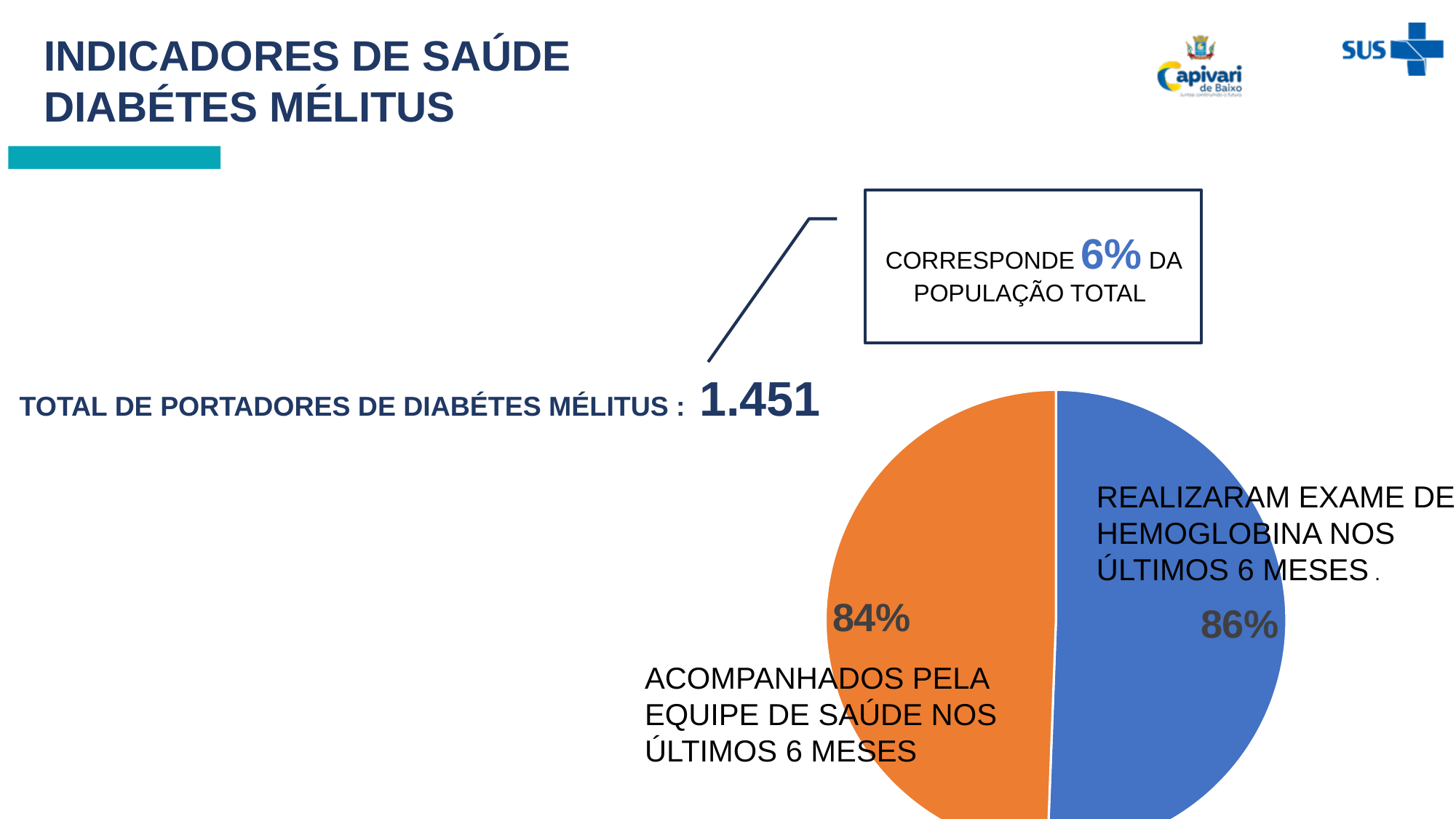
What value is labelled on the slice for 'Acompanhados pela equipe de saúde nos últimos 6 meses'? 84% According to the slide, what percentage of the total population do the diabetes patients correspond to? 6% Which slice has the lowest labelled value? Acompanhados pela equipe de saúde nos últimos 6 meses How many slices does the pie chart have? 2 What is the difference between the labelled values of the two slices? 2% What is the total number of diabetes mellitus patients stated on the slide? 1.451 What kind of chart is shown on the slide? Pie chart Which slice has the higher labelled value, 'Acompanhados pela equipe de saúde' or 'Realizaram exame de hemoglobina'? Realizaram exame de hemoglobina What value is labelled on the slice for 'Realizaram exame de hemoglobina nos últimos 6 meses'? 86% What colour is the slice labelled 84%? Orange What colour is the slice for 'Realizaram exame de hemoglobina nos últimos 6 meses'? Blue